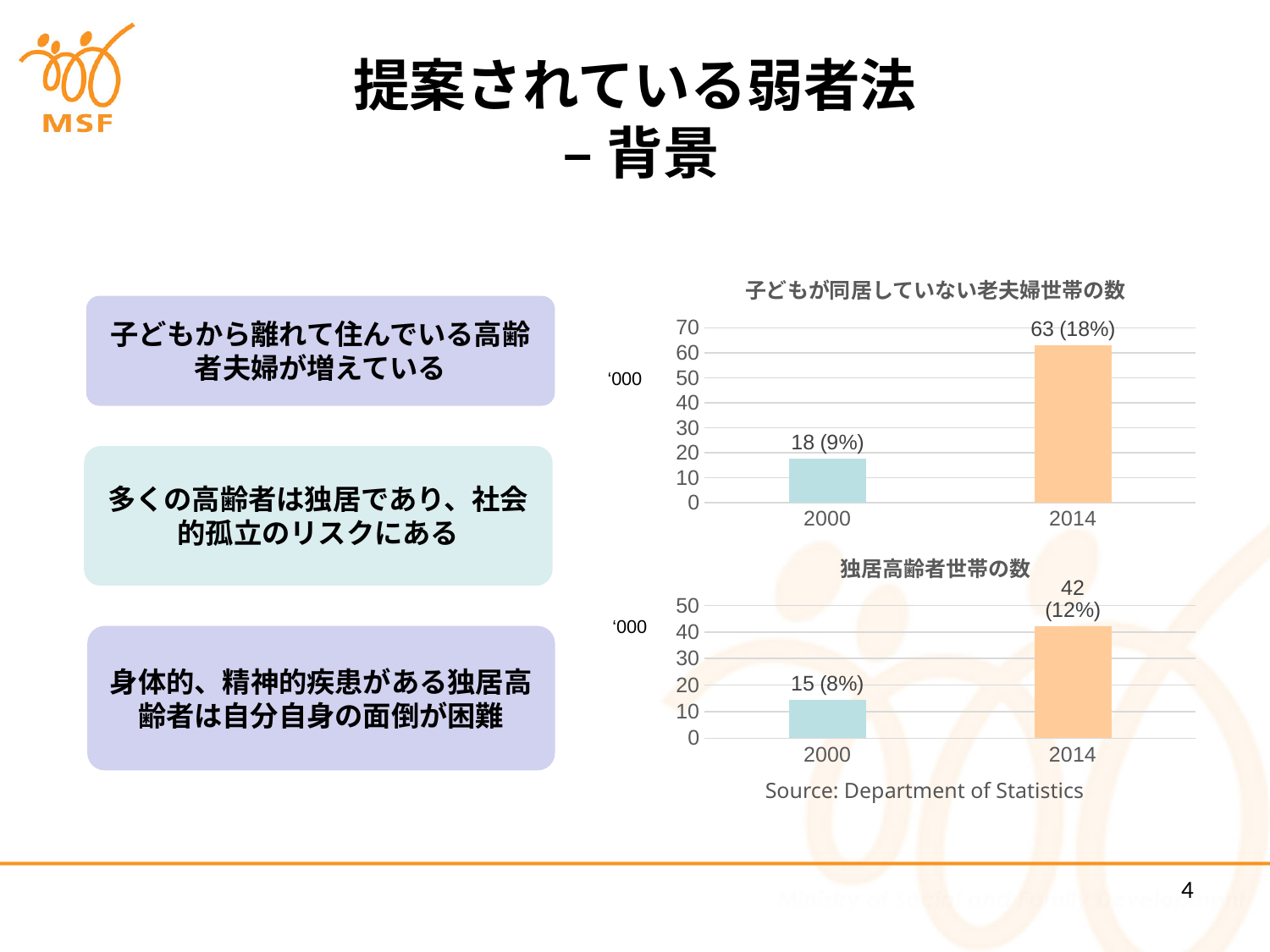
What is the source cited below the charts? Department of Statistics In the top chart (子どもが同居していない老夫婦世帯の数), what is the data label for 2000? 18 (9%) In the bottom chart (独居高齢者世帯の数), which year has the lower value? 2000 In the top chart (子どもが同居していない老夫婦世帯の数), what is the data label for 2014? 63 (18%) In the top chart (子どもが同居していない老夫婦世帯の数), which year has the higher value? 2014 In the bottom chart (独居高齢者世帯の数), is the value for 2014 greater or less than 40? greater In the bottom chart (独居高齢者世帯の数), what is the data label for 2014? 42 (12%) What type of chart is the bottom chart (独居高齢者世帯の数)? Bar chart In the top chart (子どもが同居していない老夫婦世帯の数), by how much (in '000) did the value increase from 2000 to 2014? 45 How many categories (years) are shown in the top chart (子どもが同居していない老夫婦世帯の数)? 2 In the bottom chart (独居高齢者世帯の数), what is the difference (in '000) between the 2014 and 2000 values? 27 In the bottom chart (独居高齢者世帯の数), what is the data label for 2000? 15 (8%)